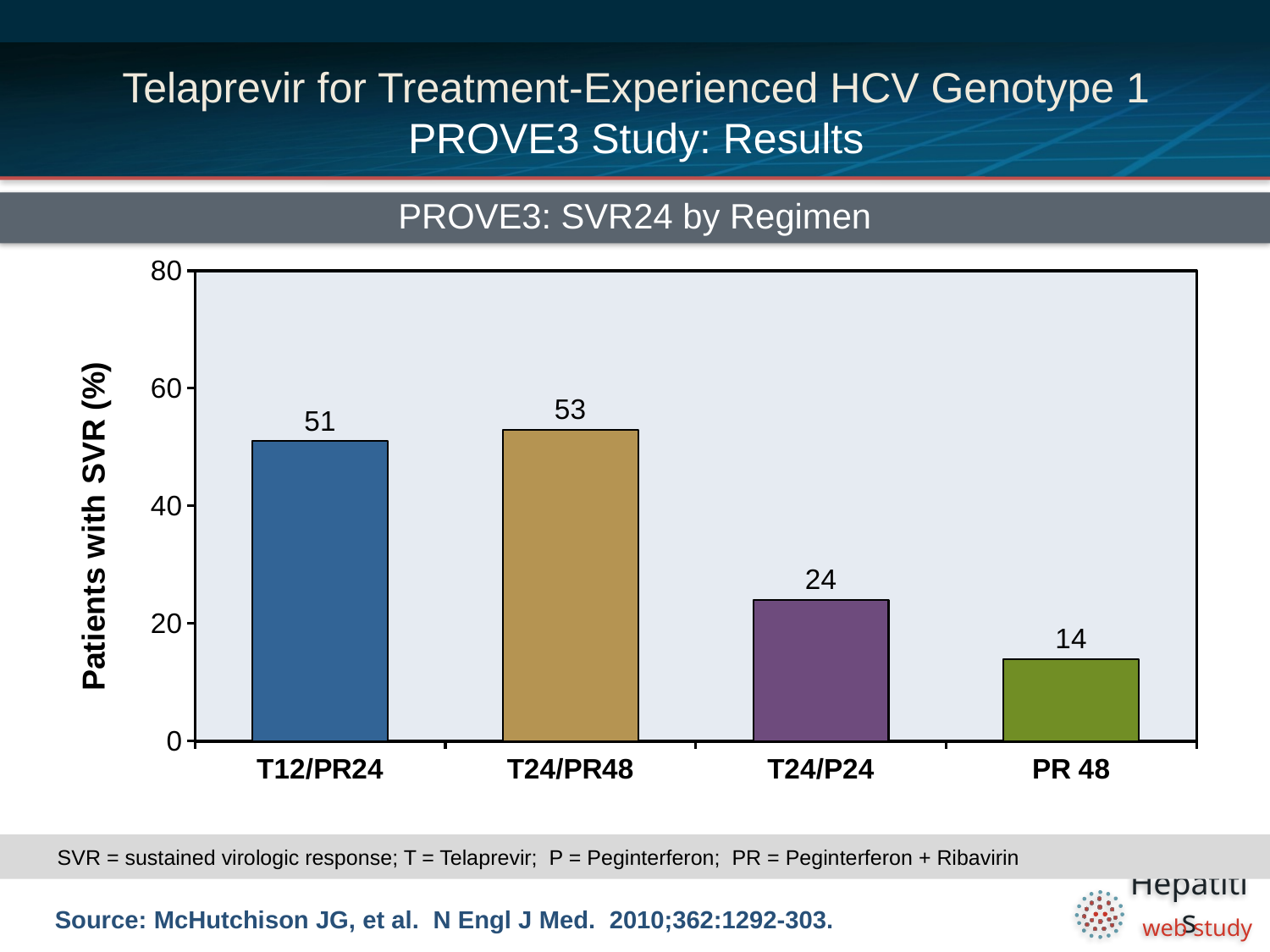
Which is larger, the value for T24/P24 or the value for PR 48? T24/P24 Which regimen has the lowest percentage of patients with SVR? PR 48 What is the value for T12/PR24? 51 Which regimen has the highest percentage of patients with SVR? T24/PR48 What is the title of the chart? PROVE3: SVR24 by Regimen What is the value for T24/PR48? 53 What is the difference between the values for T12/PR24 and T24/P24? 27 What is the value for PR 48? 14 What is the difference between the values for T24/PR48 and PR 48? 39 How many regimens are shown on the chart? 4 What kind of chart is shown on the slide? Bar chart What is the value for T24/P24? 24